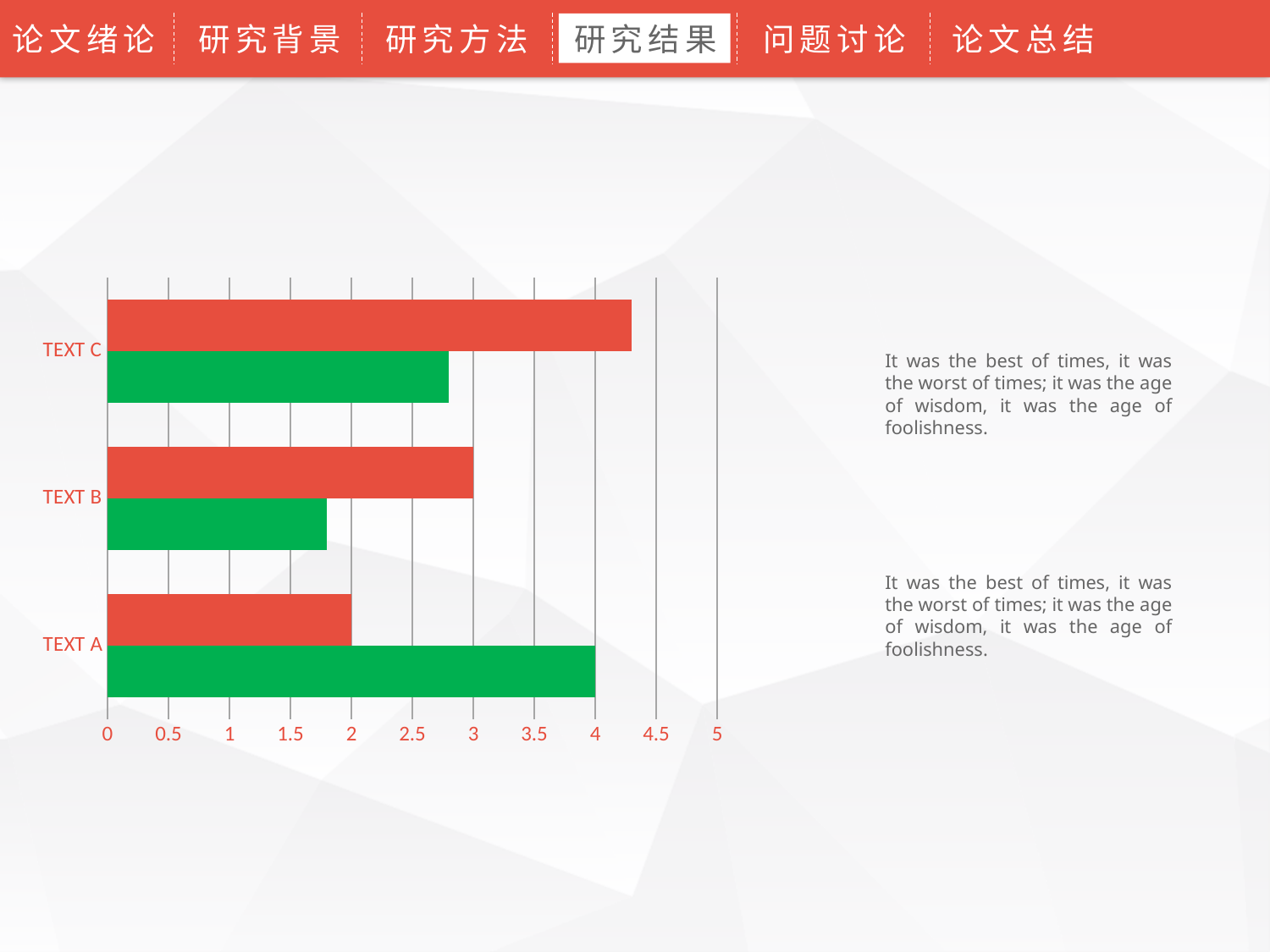
What kind of chart is shown on the slide? bar chart Is the value of the green bar for TEXT C greater or less than 3? less Is the value of the red bar for TEXT C greater or less than 4? greater How many categories are shown on the chart? 3 For TEXT A, which bar is longer, the red one or the green one? green What is the value of the red bar for TEXT A? 2 Which category has the longest red bar? TEXT C Is the value of the green bar for TEXT B greater or less than 2? less What is the difference between the green bar and the red bar for TEXT A? 2 Which category has the shortest green bar? TEXT B What is the value of the green bar for TEXT A? 4 What is the value of the red bar for TEXT B? 3